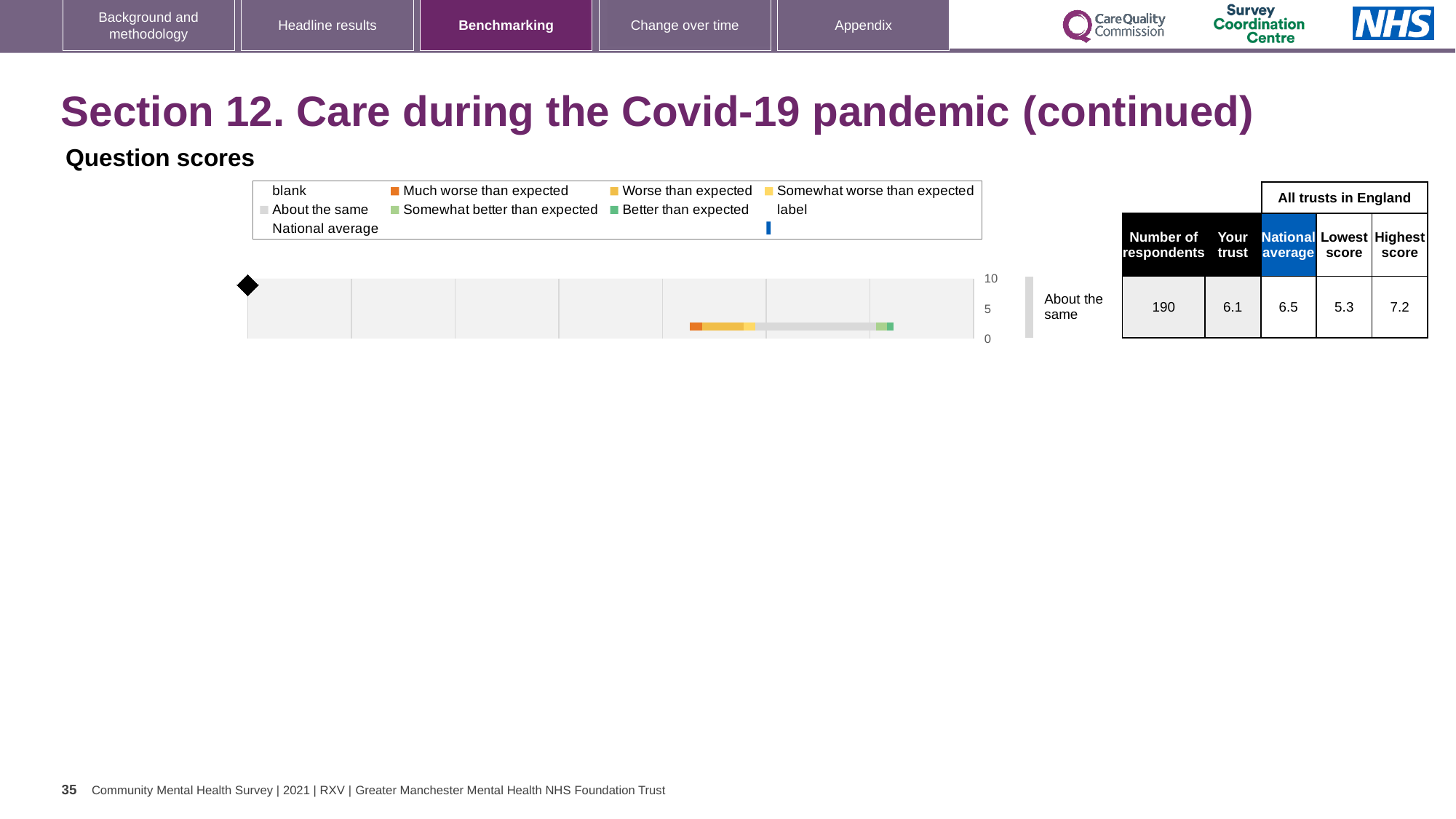
What is the 'Your trust' score shown next to the chart? 6.1 What is the maximum value shown on the chart's vertical axis? 10 What benchmark category is the trust's result labelled as next to the chart? About the same In the chart legend, which colour represents 'Much worse than expected'? orange What kind of chart is shown under 'Question scores'? bar chart What is the Lowest score among all trusts in England shown next to the chart? 5.3 What is the difference between the Highest score and the Lowest score? 1.9 Which is larger, the 'Your trust' score or the National average score? National average What is the Highest score among all trusts in England shown next to the chart? 7.2 What is the National average score shown next to the chart? 6.5 What does the blue marker in the chart legend represent? National average How many respondents are shown for this question? 190